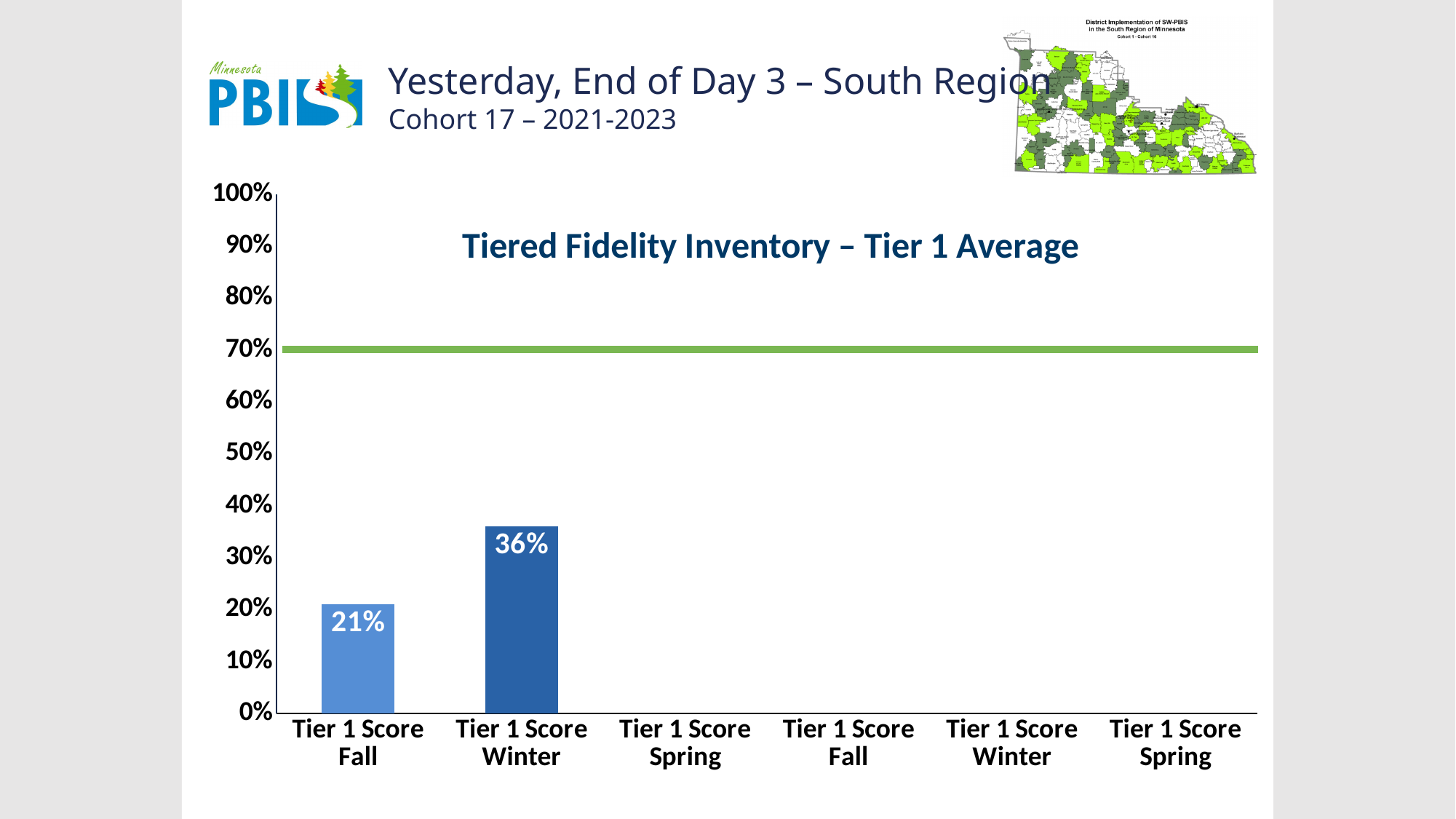
What is the value of the first Tier 1 Score Fall bar? 21% Is the value for Tier 1 Score Winter greater or less than 40%? less What is the difference between the Tier 1 Score Winter bar and the first Tier 1 Score Fall bar? 15% Which is larger, the Tier 1 Score Winter bar or the first Tier 1 Score Fall bar? Tier 1 Score Winter What is the value of the Tier 1 Score Winter bar? 36% Which category has the lowest plotted bar? Tier 1 Score Fall What kind of chart is shown on the slide? Bar chart Which category has the highest plotted bar? Tier 1 Score Winter How many category labels are shown along the x axis? 6 Is the value for the first Tier 1 Score Fall bar greater or less than 30%? less How many bars are actually plotted on the chart? 2 At what level is the green horizontal line drawn across the chart? 70%